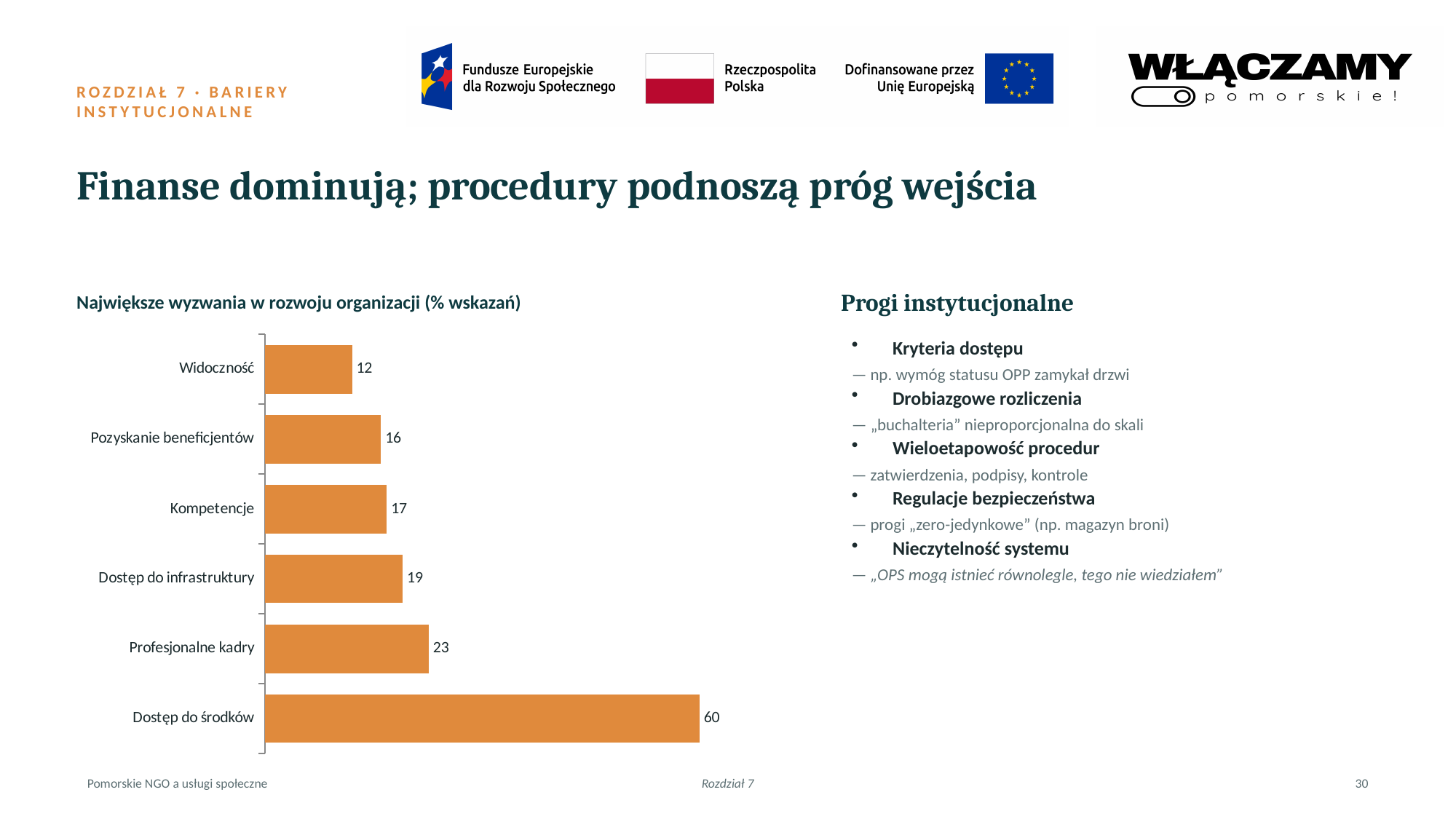
Which category has the lowest value? Widoczność What is the value for Widoczność? 12 What is the value for Pozyskanie beneficjentów? 16 What is the title of the chart? Największe wyzwania w rozwoju organizacji (% wskazań) What kind of chart is shown on the slide? Bar chart Which is larger, Kompetencje or Pozyskanie beneficjentów? Kompetencje What is the value for Dostęp do środków? 60 Which category has the highest value? Dostęp do środków What is the difference between Dostęp do środków and Profesjonalne kadry? 37 What is the value for Profesjonalne kadry? 23 How many categories are shown in the chart? 6 What is the difference between Dostęp do infrastruktury and Kompetencje? 2